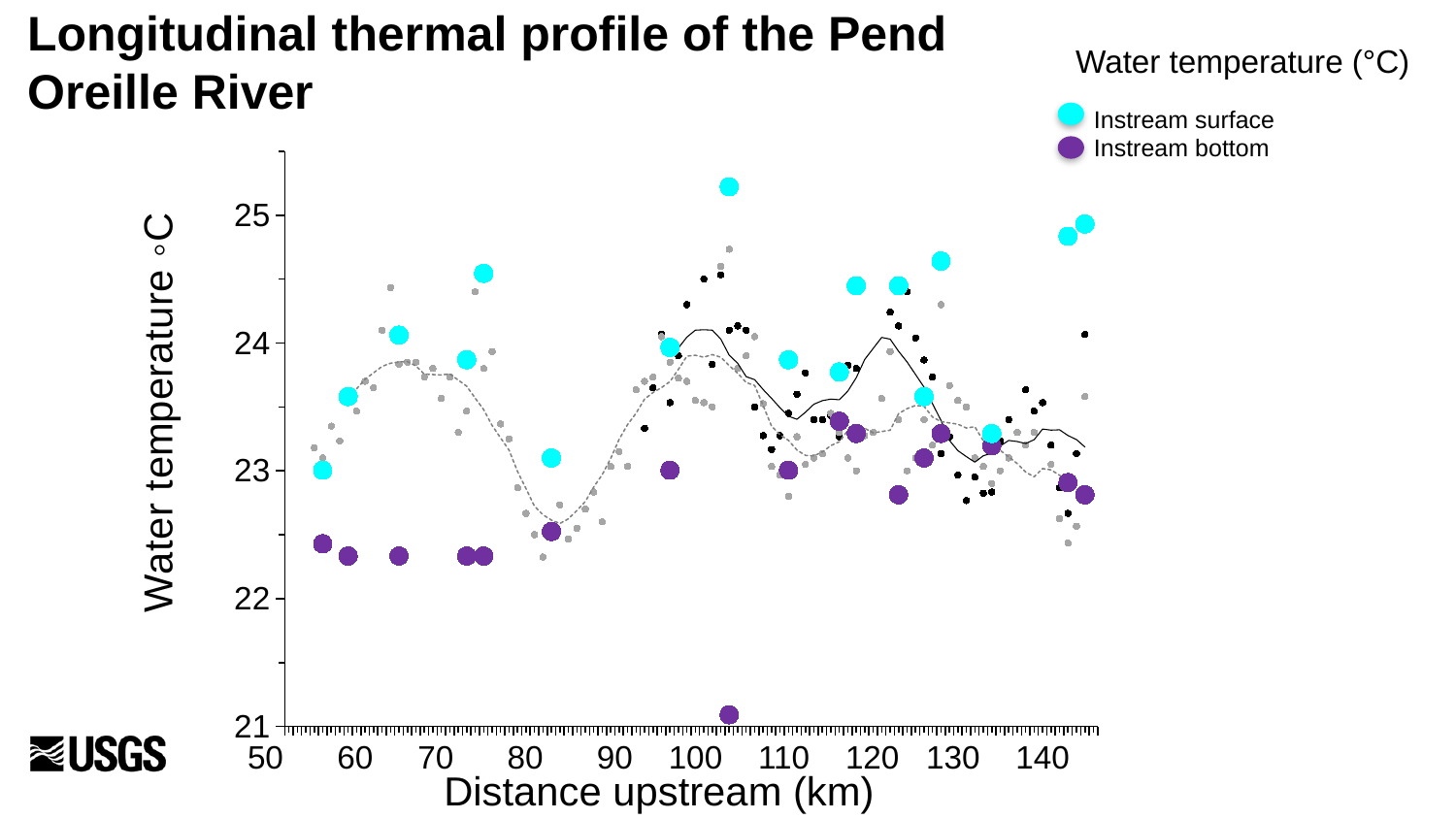
Is the highest Instream surface value greater or less than 25? greater Is the Instream surface value at about 83 km greater or less than 24? less What kind of chart is shown on the slide? Scatter plot What is the title of the chart? Longitudinal thermal profile of the Pend Oreille River At about 56 km, which is larger: the Instream surface value or the Instream bottom value? Instream surface Is the lowest Instream bottom value greater or less than 22? less Which series has the lowest plotted point on the chart? Instream bottom What is the label of the x axis? Distance upstream (km) How many series does the legend list? 2 Between about 55 km and 65 km, do the Instream surface values rise or fall? rise Which series has the highest plotted point on the chart? Instream surface